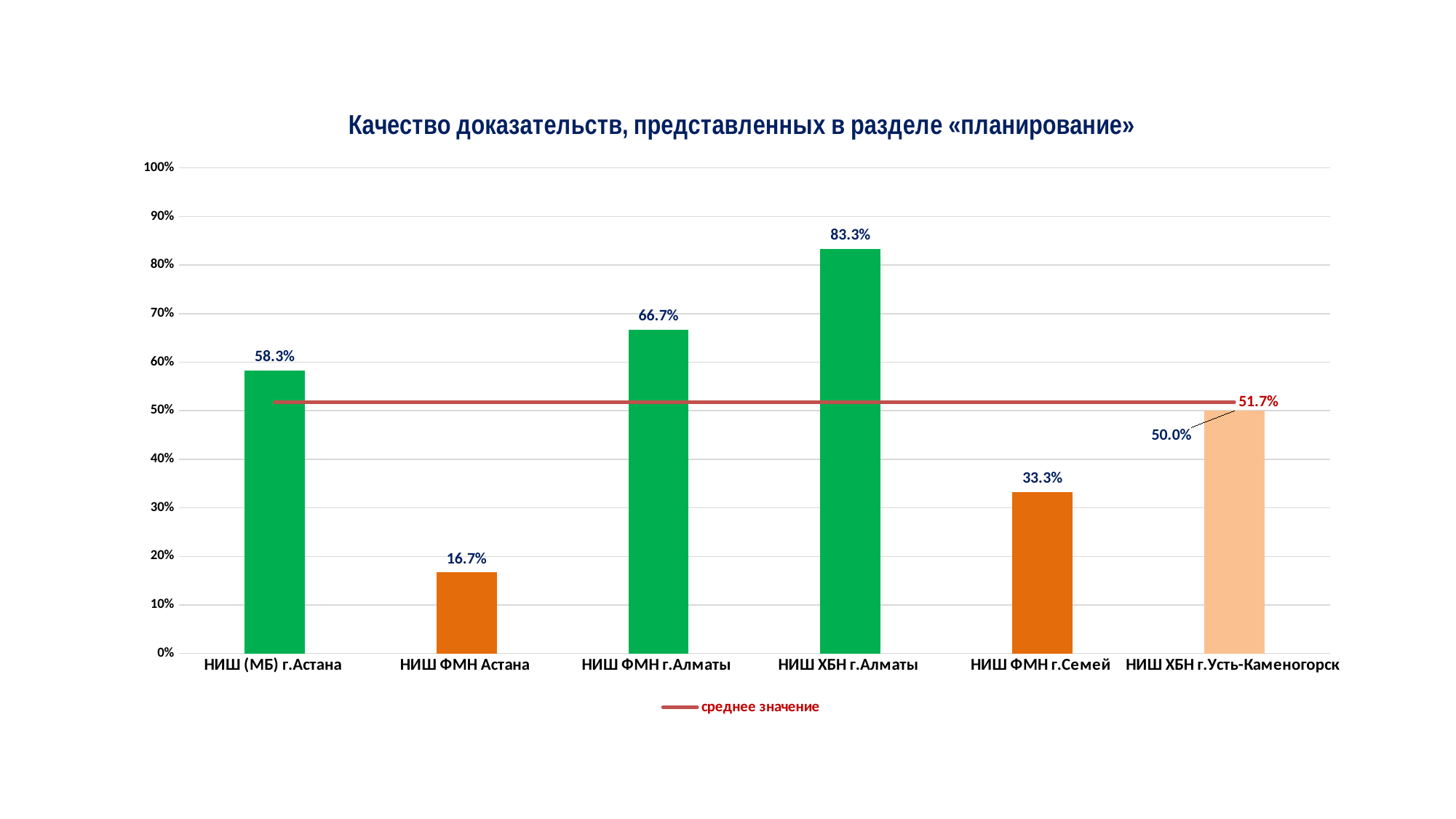
Which category has the lowest value? НИШ ФМН Астана Which category has the highest value? НИШ ХБН г.Алматы How many categories are shown on the x axis? 6 Which is larger, the value for НИШ (МБ) г.Астана or the value for НИШ ФМН г.Алматы? НИШ ФМН г.Алматы Is the value for НИШ ФМН г.Семей greater or less than 40%? less What kind of chart is this? combination bar and line chart What is the difference between the values for НИШ ХБН г.Алматы and НИШ ФМН г.Семей? 50.0% What is the value of the среднее значение line? 51.7% What is the title of the chart? Качество доказательств, представленных в разделе «планирование» What is the value for НИШ ХБН г.Алматы? 83.3% What is the value for НИШ ХБН г.Усть-Каменогорск? 50.0% What is the value for НИШ ФМН Астана? 16.7%